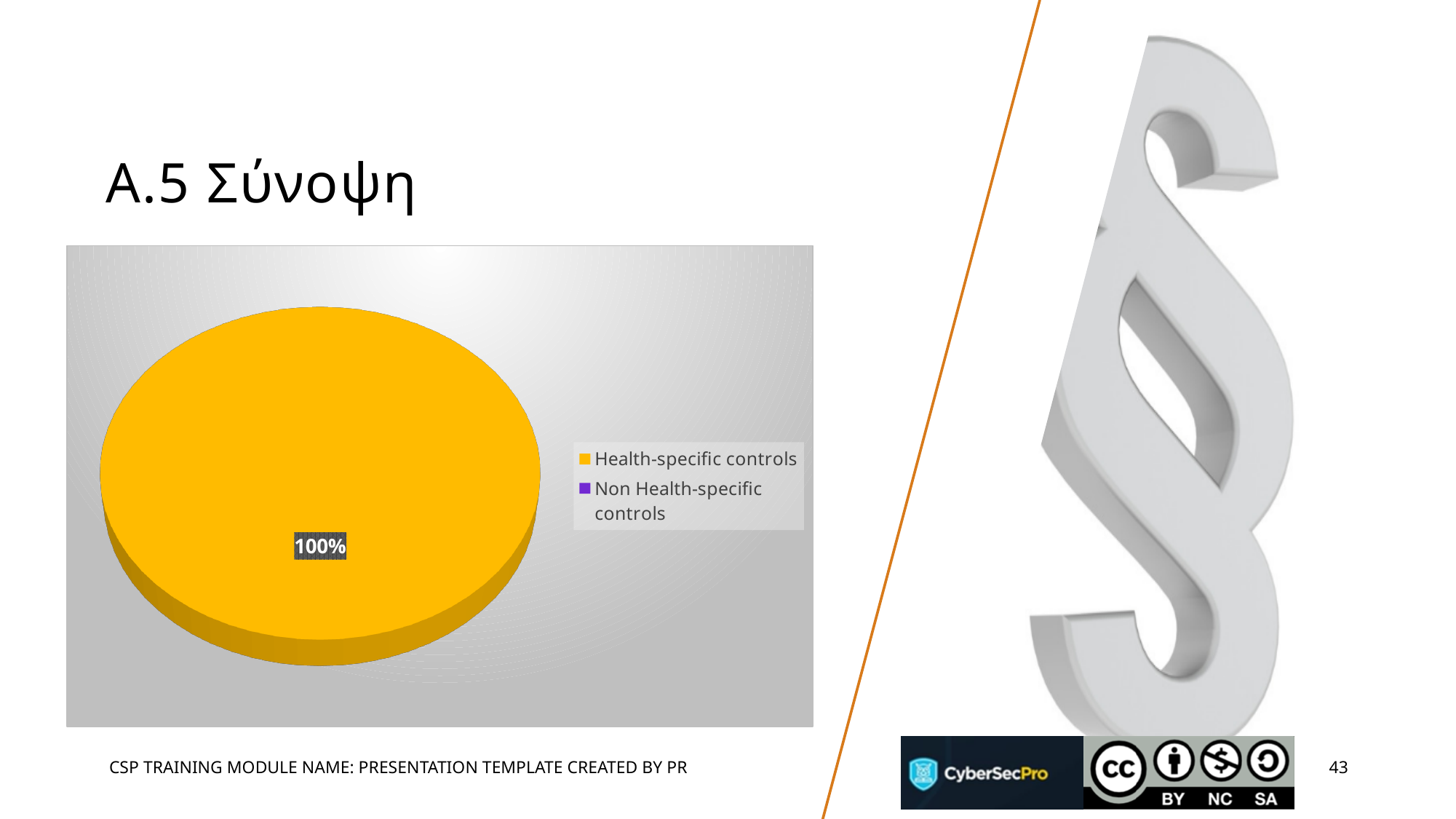
How many entries does the legend of the pie chart list? 2 Which is larger in the pie chart, Health-specific controls or Non Health-specific controls? Health-specific controls What percentage is shown for Health-specific controls in the pie chart? 100% What is the only data label printed on the pie chart? 100% What kind of chart is shown on the slide? Pie chart Which category has the largest slice in the pie chart? Health-specific controls What colour does the legend assign to Non Health-specific controls? Purple What colour is used for Health-specific controls in the pie chart? Yellow What share of the pie does the Health-specific controls slice take up? 100% Which category has the smallest share in the pie chart? Non Health-specific controls